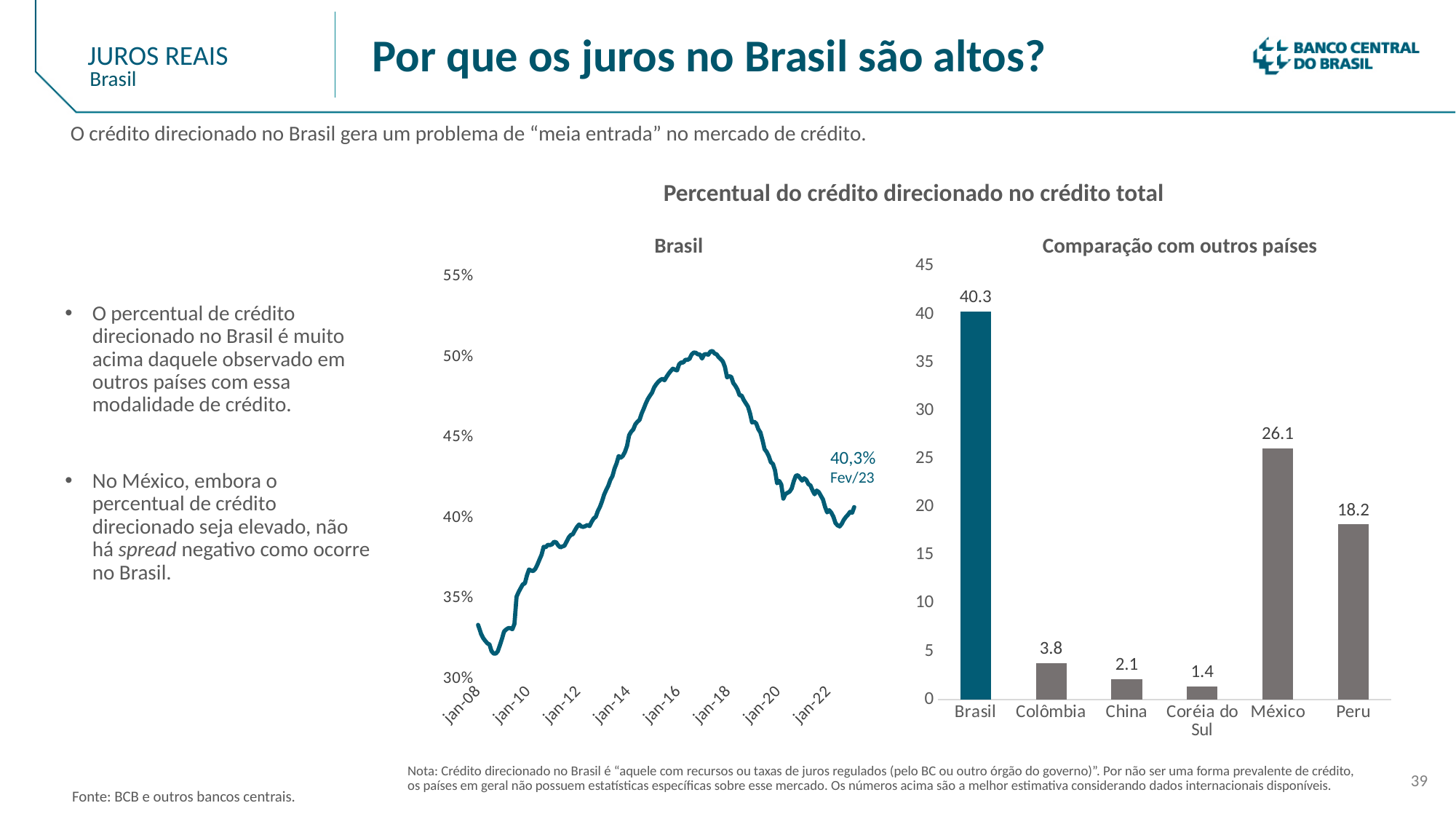
In the 'Comparação com outros países' chart, what is the value for Colômbia? 3.8 In the 'Comparação com outros países' chart, which is larger, the value for Peru or the value for China? Peru In the 'Comparação com outros países' chart, which country has the lowest value? Coréia do Sul In the 'Brasil' line chart, what is the value labelled at the end of the series for Fev/23? 40,3% In the 'Brasil' line chart, is the value at jan-08 greater or less than 35%? less In the 'Comparação com outros países' chart, which country has the highest value? Brasil In the 'Comparação com outros países' chart, what is the difference between the values for Brasil and México? 14.2 What kind of chart is the 'Brasil' chart on the left? Line chart In the 'Brasil' line chart, does the series rise or fall between jan-18 and jan-22? Fall In the 'Comparação com outros países' chart, how many countries are shown? 6 In the 'Comparação com outros países' chart, what is the value for México? 26.1 What kind of chart is the 'Comparação com outros países' chart? Bar chart